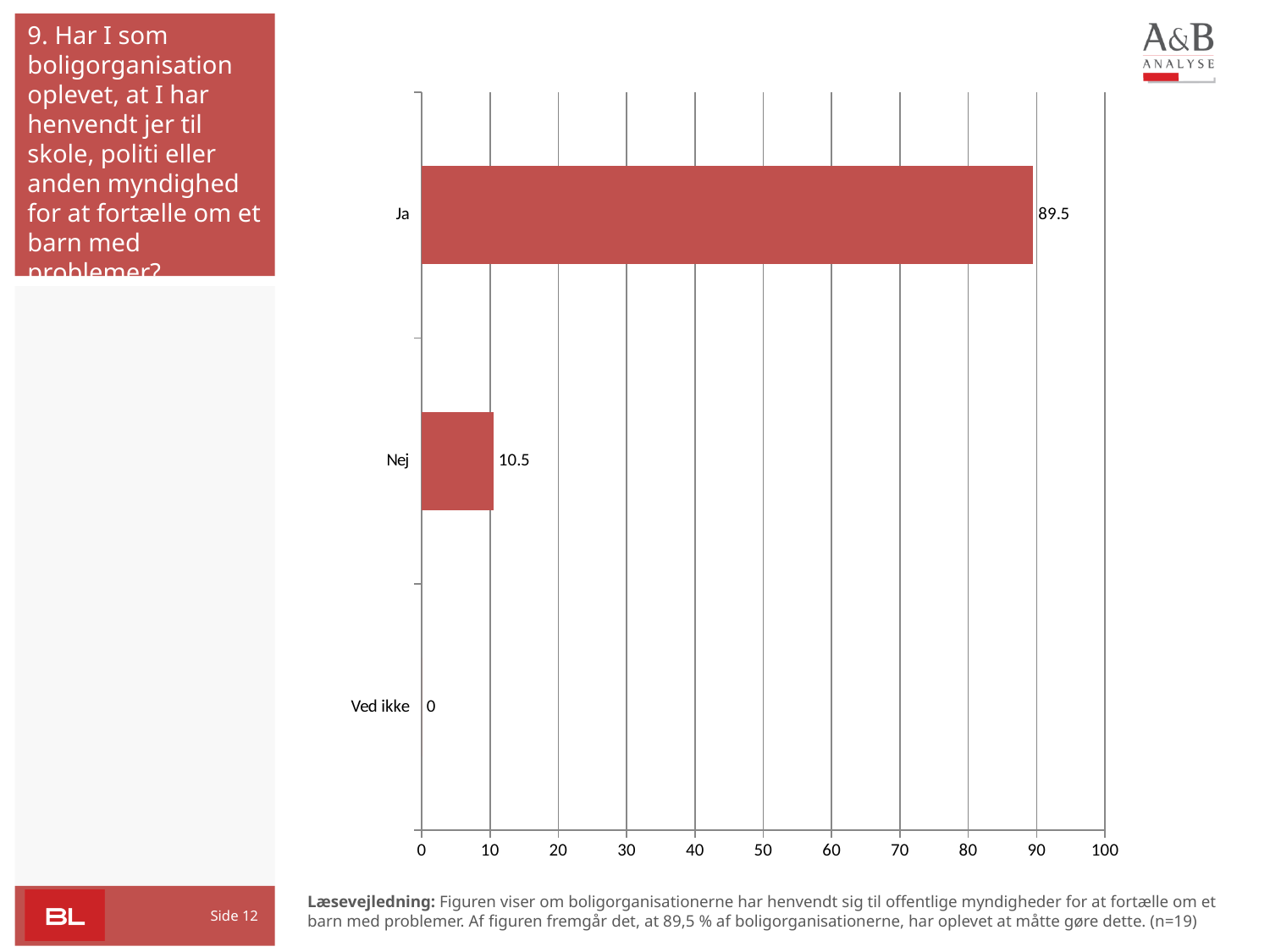
Which category has the lowest value? Ved ikke What is the difference between the values for Ja and Nej? 79 Which category has the highest value? Ja Is the value for Nej greater or less than 20? less Is the value for Ja greater or less than 80? greater What is the value for Nej? 10.5 Which is larger, the value for Ja or the value for Nej? Ja What is the value for Ja? 89.5 What kind of chart is shown on the slide? bar chart How many categories are shown in the chart? 3 What is the maximum value shown on the x axis? 100 What is the value for Ved ikke? 0